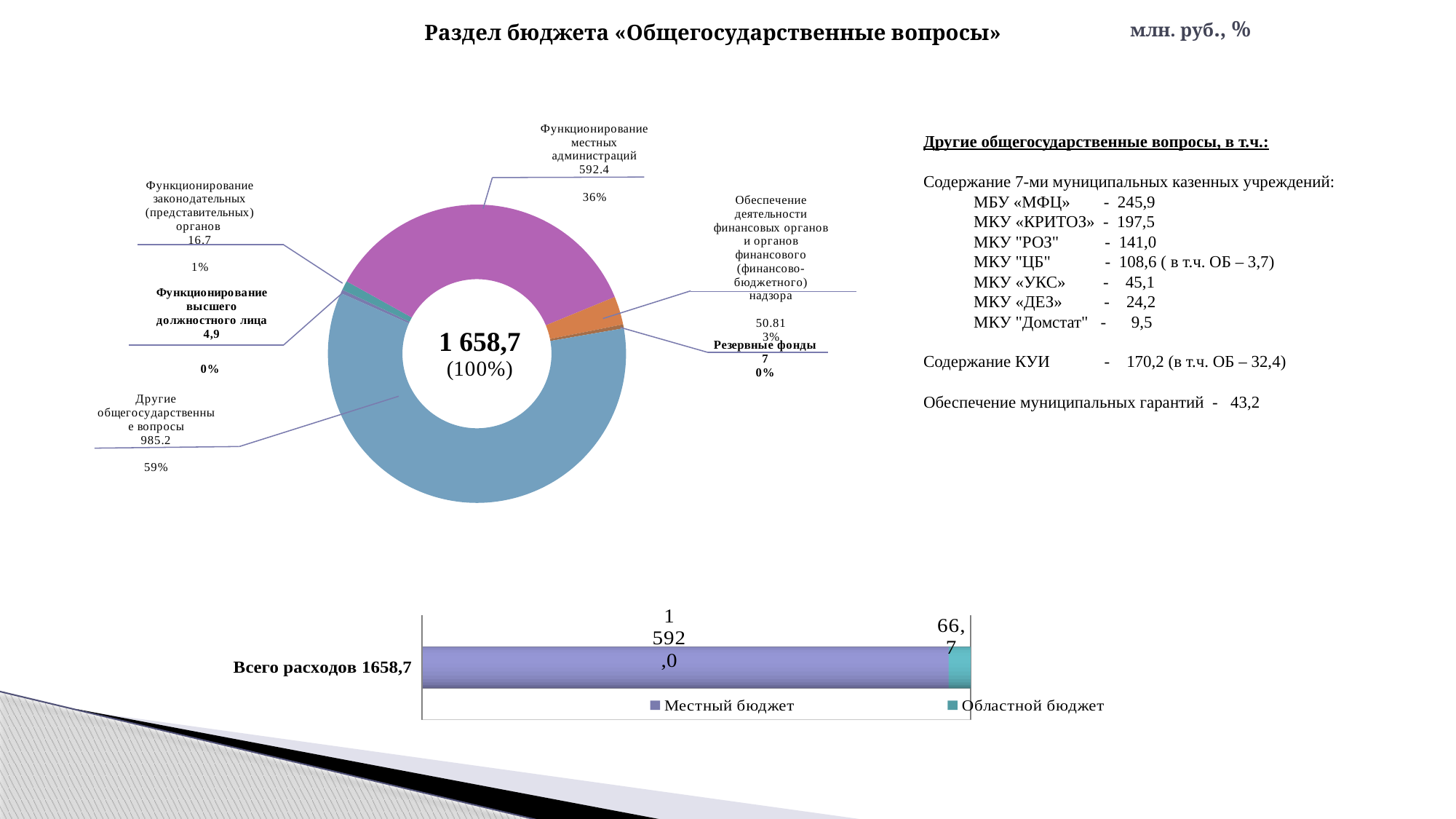
In the doughnut chart, what percentage share is shown for «Функционирование законодательных (представительных) органов»? 1% In the doughnut chart, which category has the largest share? Другие общегосударственные вопросы In the doughnut chart, what value is shown for «Резервные фонды»? 7 In the bottom bar chart, what value is shown for «Областной бюджет»? 66,7 In the doughnut chart, what percentage share is shown for «Функционирование местных администраций»? 36% In the doughnut chart, what value is shown for «Другие общегосударственные вопросы»? 985.2 In the doughnut chart, how many categories are shown? 6 In the bottom bar chart, what value is shown for «Местный бюджет»? 1 592,0 In the doughnut chart, what total is shown in the centre? 1 658,7 In the doughnut chart, which category has the smallest value? Функционирование высшего должностного лица In the doughnut chart, which is larger: «Функционирование местных администраций» or «Обеспечение деятельности финансовых органов»? Функционирование местных администраций In the bottom bar chart, how many series does the legend list? 2